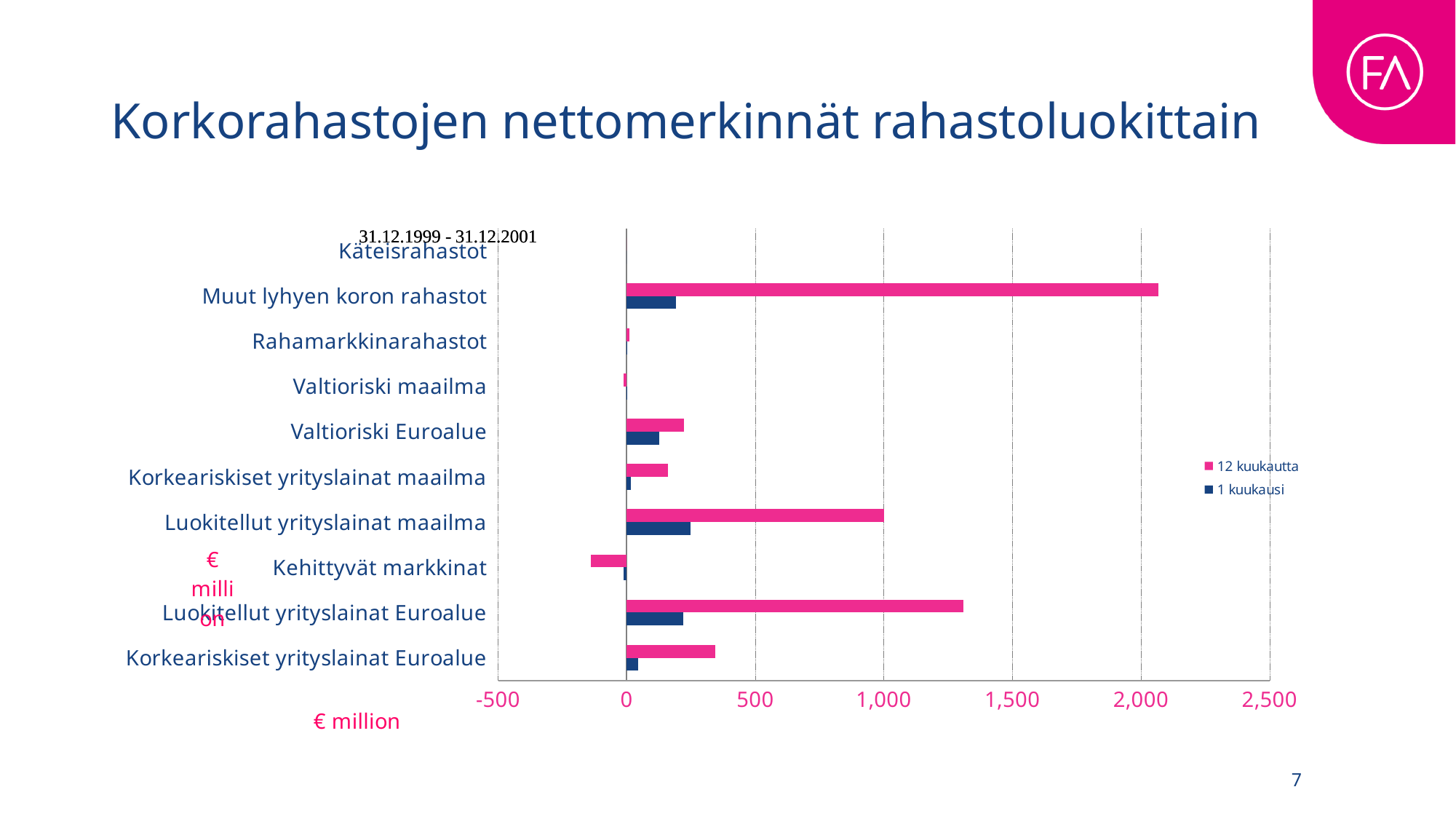
What unit is shown below the horizontal axis of the chart? € million Which category has the highest value for the 12 kuukautta series? Muut lyhyen koron rahastot Is the 12 kuukautta value for Muut lyhyen koron rahastot greater or less than 2,000? greater For the 12 kuukautta series, which is larger: Luokitellut yrityslainat Euroalue or Luokitellut yrityslainat maailma? Luokitellut yrityslainat Euroalue How many series does the legend list? 2 For the 1 kuukausi series, which is larger: Luokitellut yrityslainat maailma or Korkeariskiset yrityslainat Euroalue? Luokitellut yrityslainat maailma What kind of chart is shown on the slide? bar chart Is the 12 kuukautta value for Kehittyvät markkinat greater or less than 0? less How many fund categories are listed on the vertical axis? 10 Is the 12 kuukautta value for Luokitellut yrityslainat Euroalue greater or less than 1,000? greater Which category has the lowest value for the 12 kuukautta series? Kehittyvät markkinat